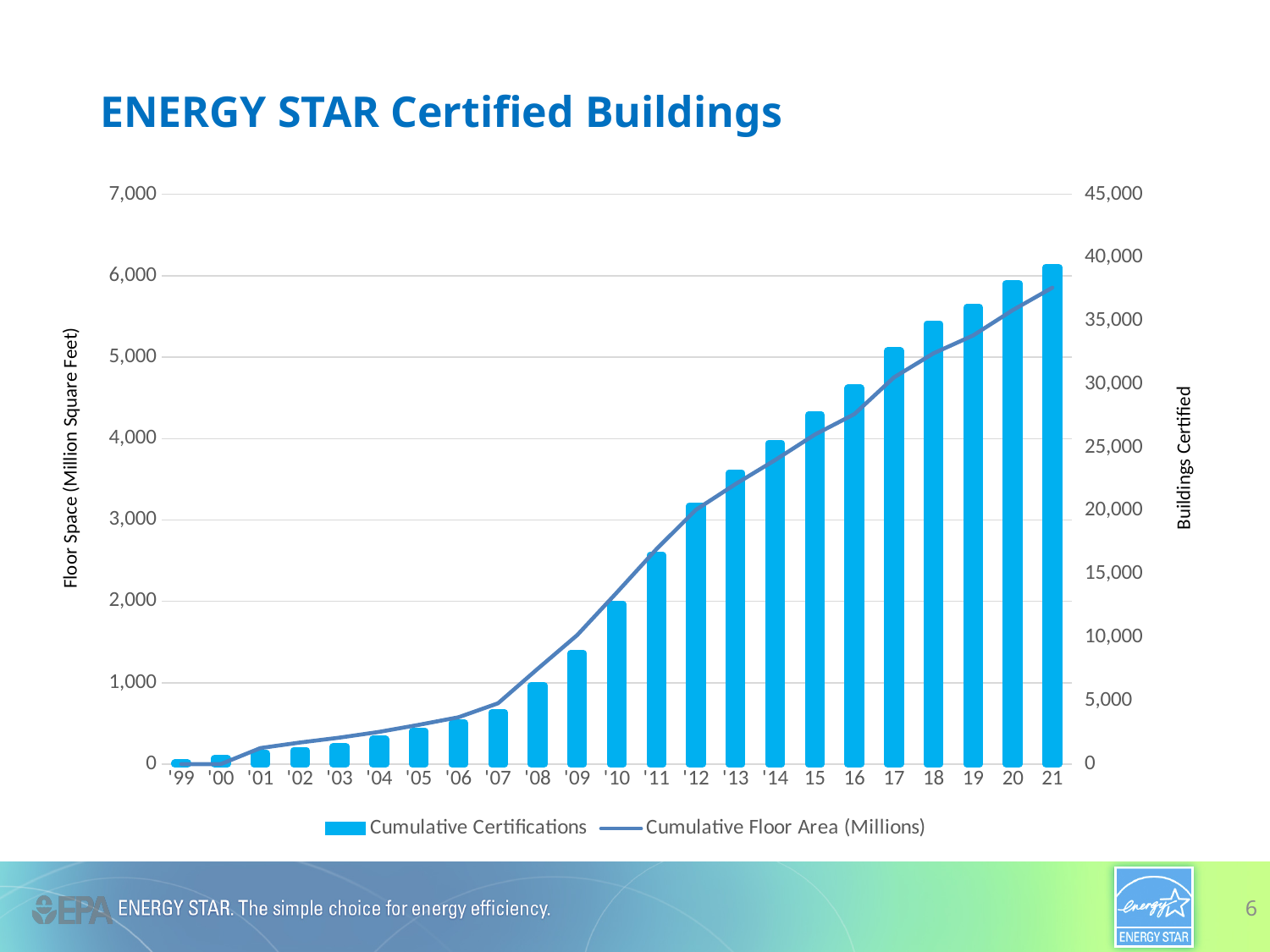
What kind of chart is this? Bar chart with a line Which year has the larger Cumulative Certifications bar, '10 or 15? 15 How many years are shown on the x axis? 23 What is the title of the chart? ENERGY STAR Certified Buildings Which year has the highest Cumulative Certifications bar? 21 Is the Cumulative Floor Area value for '07 greater or less than 1,000? less Which year has the lowest Cumulative Certifications bar? '99 What is the label of the right-hand vertical axis? Buildings Certified Is the Cumulative Certifications value for '10 greater or less than 10,000? greater Do the Cumulative Certifications bars rise or fall from '99 to 21? Rise Is the Cumulative Certifications value for 21 greater or less than 35,000? greater How many series does the legend list? 2